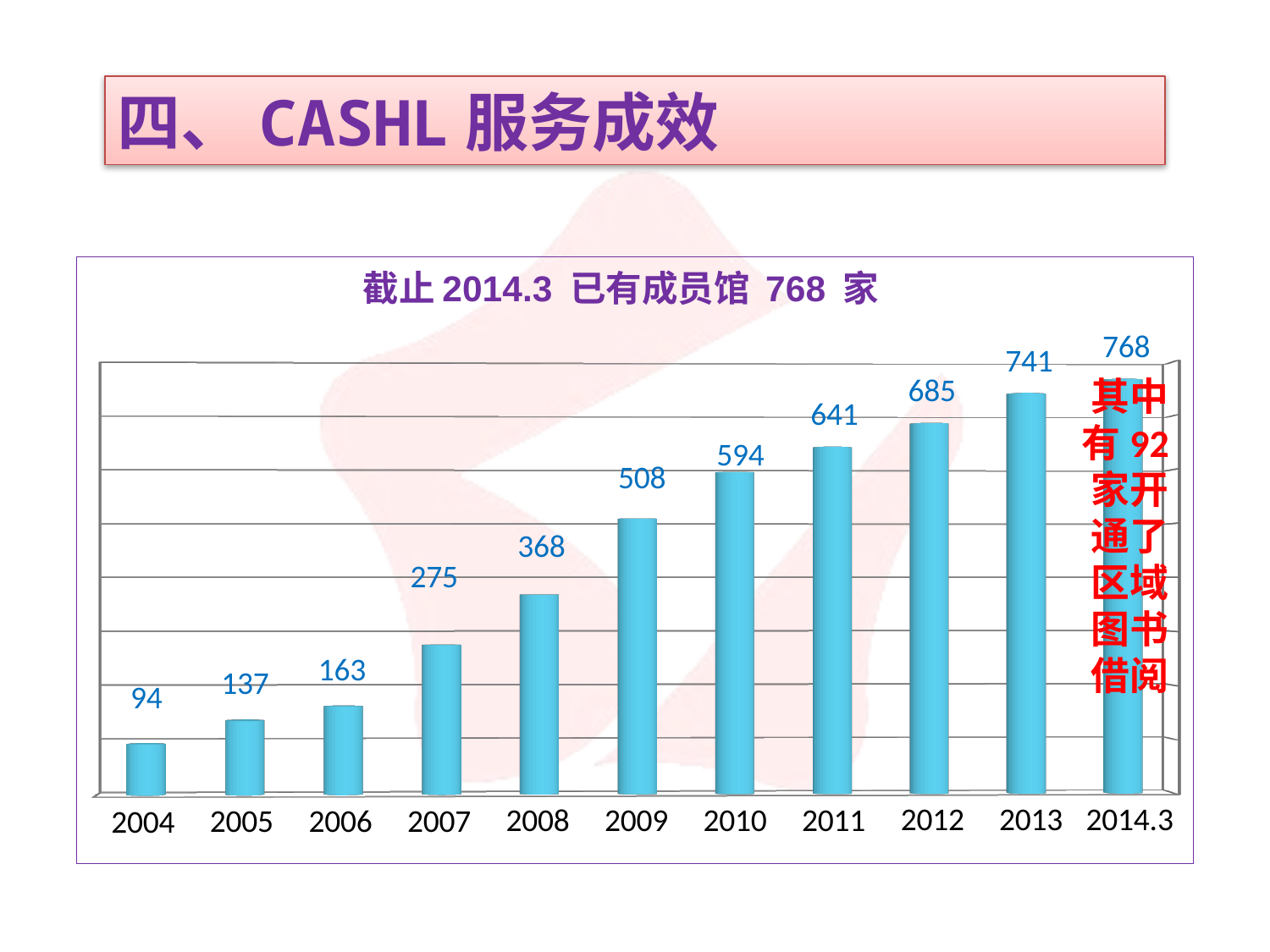
What is the title of the chart? 截止2014.3 已有成员馆 768 家 What is the difference between the values for 2009 and 2007? 233 Which is larger, the value for 2010 or the value for 2006? 2010 Which category has the lowest value? 2004 What kind of chart is this? bar chart What is the difference between the values for 2013 and 2012? 56 Which category has the highest value? 2014.3 Do the values rise or fall from 2004 to 2014.3? rise What is the value for 2008? 368 How many categories are shown on the x axis? 11 What is the value for 2011? 641 What is the value for 2004? 94